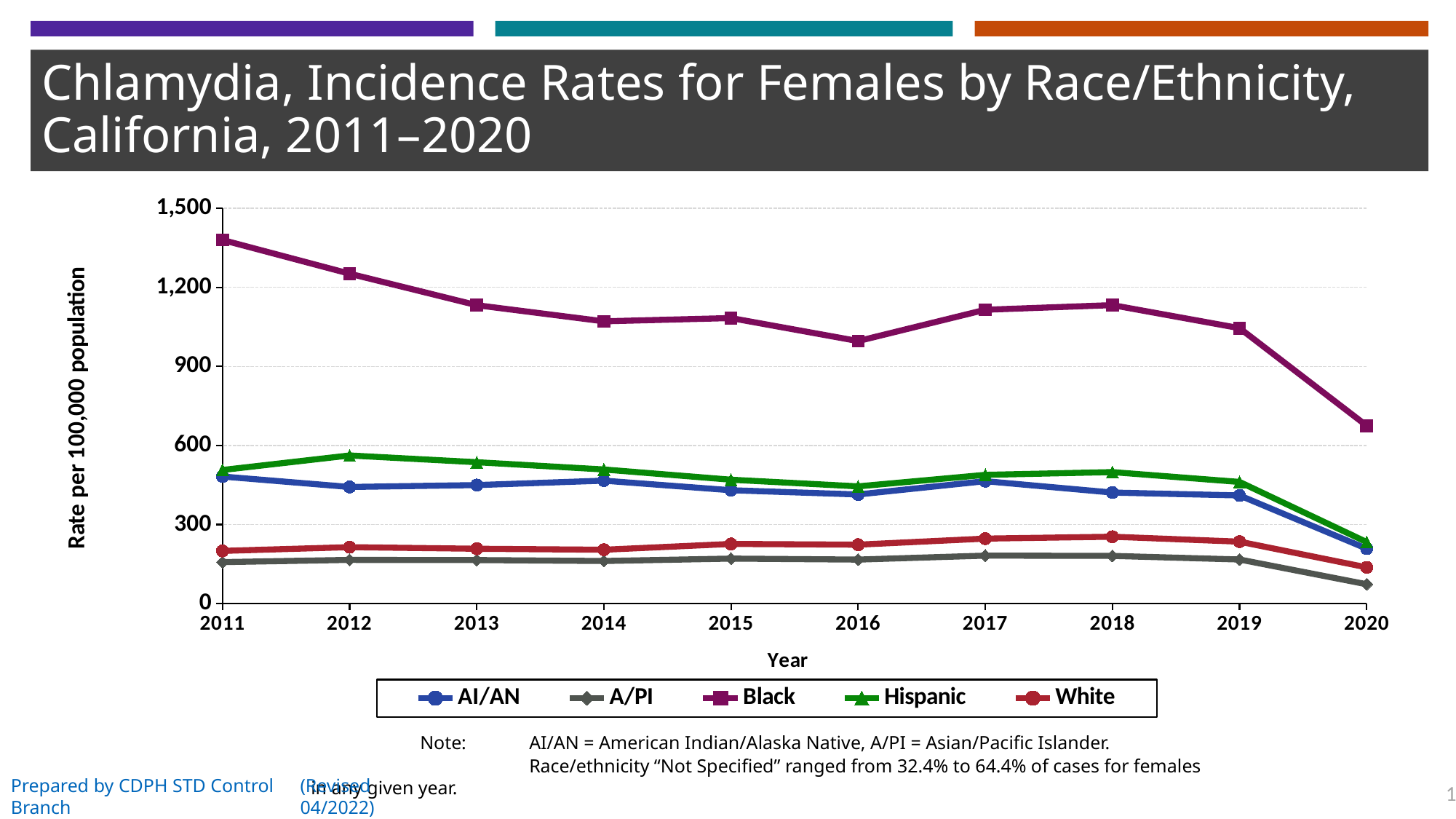
Which race/ethnicity group has the lowest incidence rate in 2020? A/PI How many series does the legend list? 5 Which race/ethnicity group has the highest incidence rate in 2011? Black Is the value for White in 2017 greater or less than 300? less How many years are plotted along the x axis? 10 Is the value for Black in 2016 greater or less than 1,200? less What kind of chart is shown on the slide? line chart Is the value for Black in 2020 greater or less than 900? less What is the label on the y axis? Rate per 100,000 population In 2012, which is higher: the rate for Hispanic or the rate for AI/AN? Hispanic Does the rate for Black rise or fall from 2011 to 2014? fall